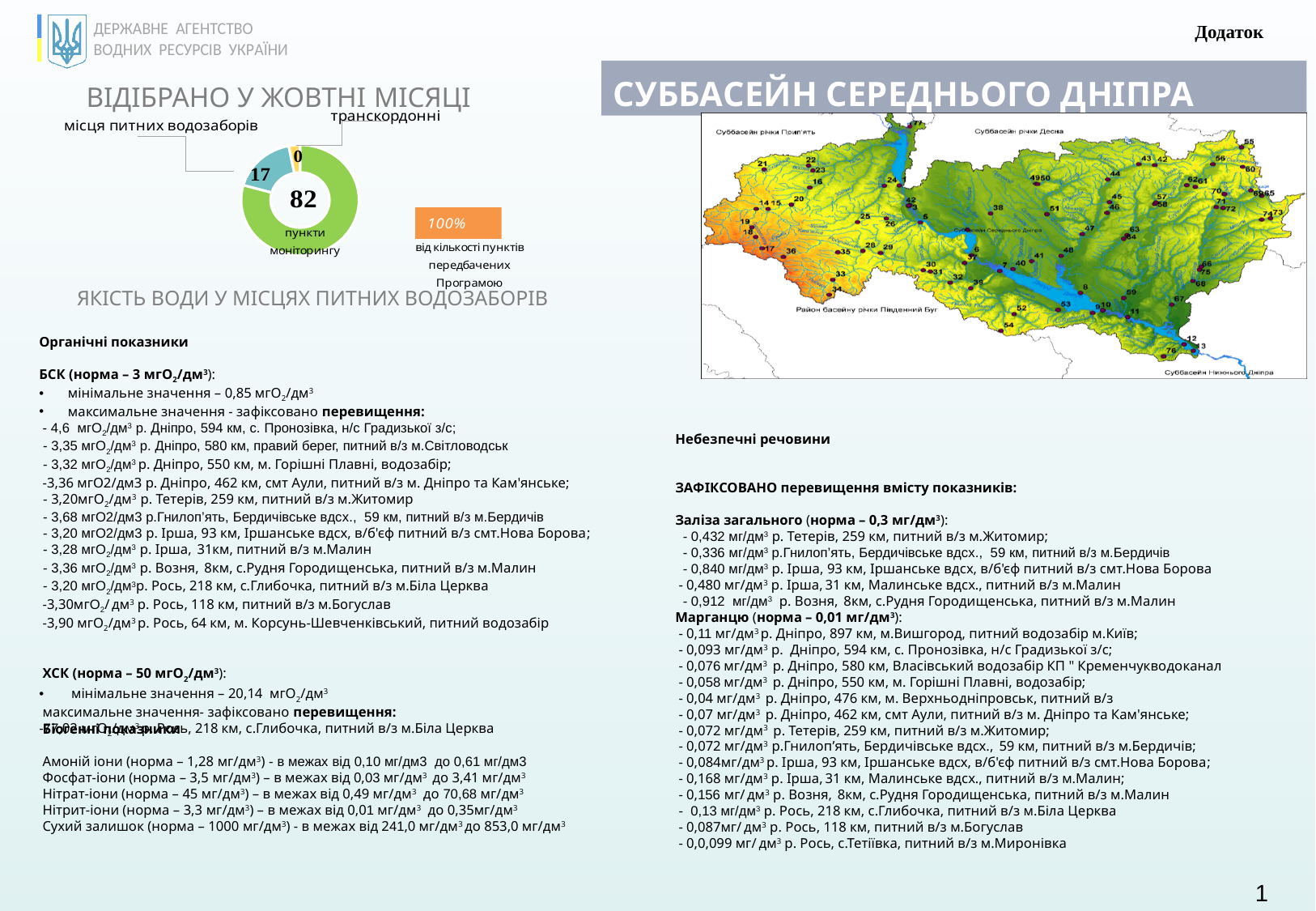
In the doughnut chart, what value is shown for транскордонні? 0 What colour is the largest segment of the doughnut chart? green Which category has the largest value in the doughnut chart? пункти моніторингу In the doughnut chart, what value is shown for місця питних водозаборів? 17 Which is larger in the doughnut chart: пункти моніторингу or місця питних водозаборів? пункти моніторингу What is the difference between the values for пункти моніторингу and місця питних водозаборів in the doughnut chart? 65 In the doughnut chart, what value is shown for пункти моніторингу? 82 Which category has the smallest value in the doughnut chart? транскордонні What kind of chart is shown under the heading ВІДІБРАНО У ЖОВТНІ МІСЯЦІ? doughnut chart How many categories are shown in the doughnut chart? 3 What is the heading above the doughnut chart? ВІДІБРАНО У ЖОВТНІ МІСЯЦІ